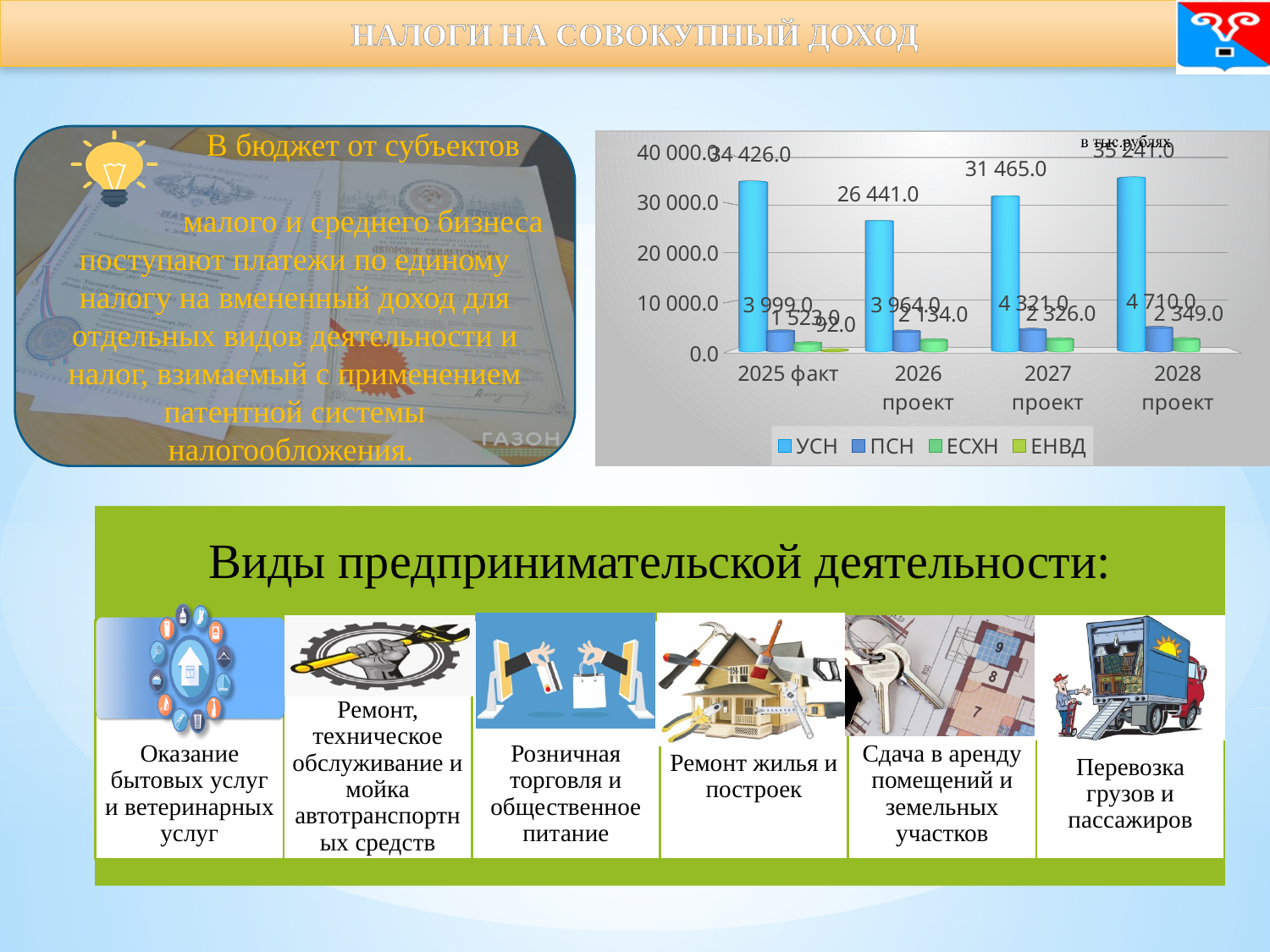
What is the value for УСН in 2025 факт? 34 426.0 How many series does the legend list? 4 In which year is the УСН value highest? 2028 проект What is the difference between the УСН values for 2028 проект and 2025 факт? 815.0 How many year categories are shown on the x axis? 4 Which is larger: the УСН value for 2027 проект or for 2026 проект? 2027 проект What is the value for УСН in 2026 проект? 26 441.0 What is the value for ПСН in 2027 проект? 4 321.0 In which year is the УСН value lowest? 2026 проект What is the value for ПСН in 2028 проект? 4 710.0 Is the УСН value for 2026 проект greater or less than 30 000.0? less What kind of chart is shown on the slide? bar chart